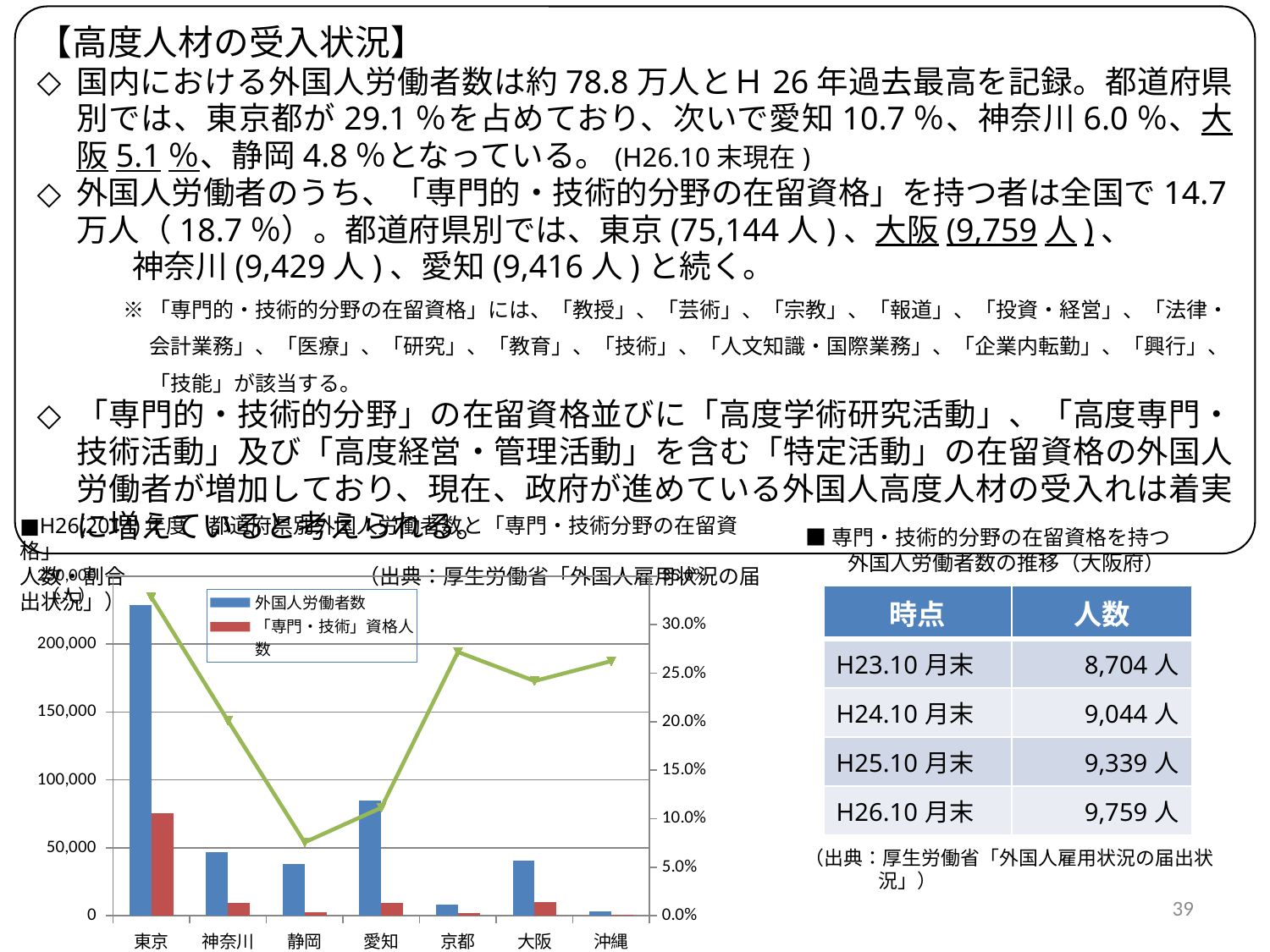
Which prefecture has the highest 外国人労働者数 bar? 東京 At which prefecture does the green line reach its lowest point? 静岡 Is the 外国人労働者数 value for 東京 greater or less than 200,000? greater Which has the larger 「専門・技術」資格人数 bar, 東京 or 愛知? 東京 Is the 外国人労働者数 value for 愛知 greater or less than 100,000? less What colour are the 外国人労働者数 bars in the chart? blue Is the 外国人労働者数 value for 静岡 greater or less than 50,000? less What kind of chart is shown at the bottom left of the slide? bar chart with a line Which prefecture has the lowest 外国人労働者数 bar? 沖縄 How many series does the chart's legend list? 2 How many prefectures are shown on the x axis of the chart? 7 Which has the larger 外国人労働者数 bar, 愛知 or 神奈川? 愛知